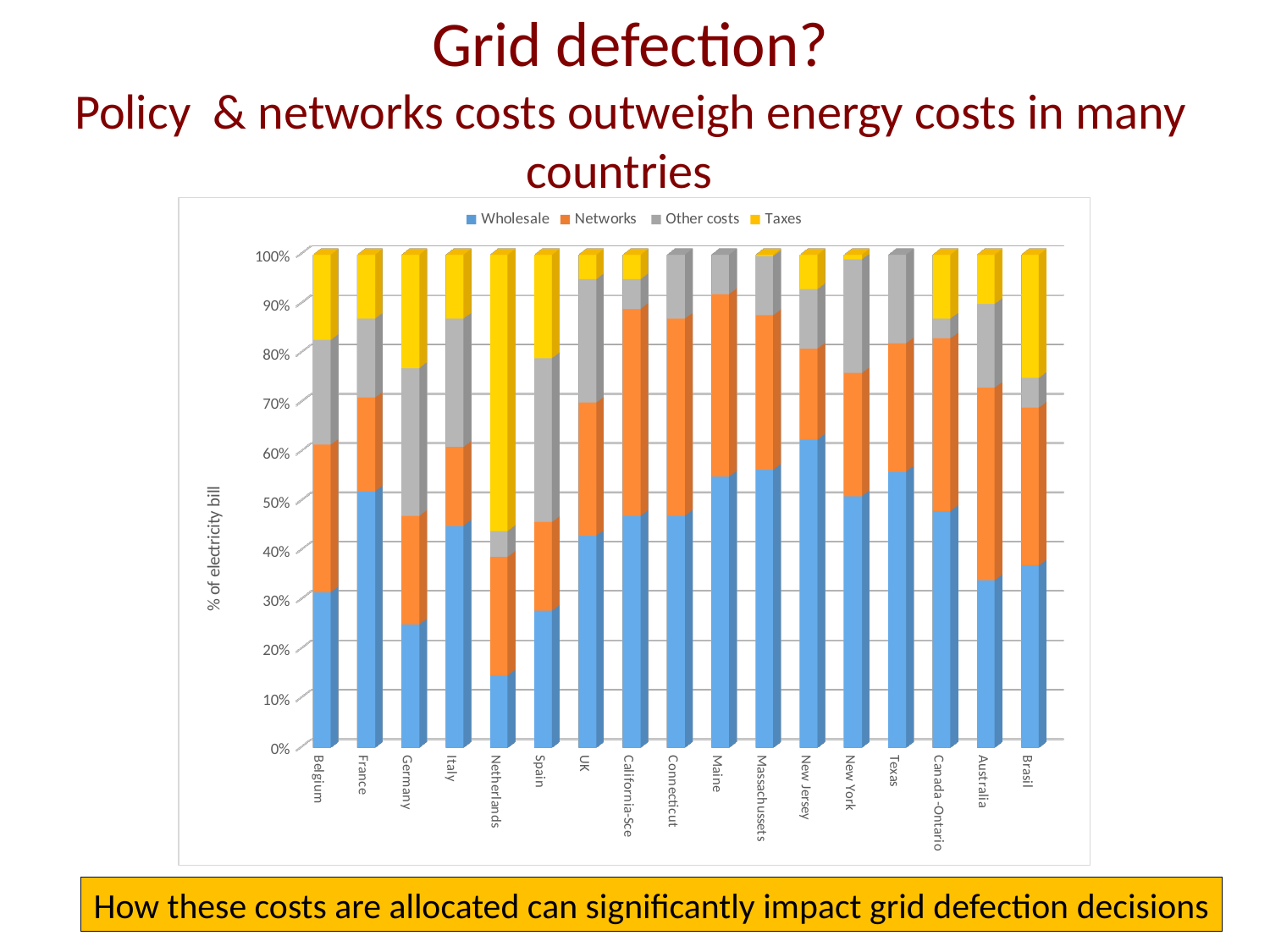
How many countries or regions are shown on the x axis? 17 Is the Wholesale share for New Jersey greater or less than 60%? greater Is the Wholesale share for Netherlands greater or less than 20%? less Is the Wholesale share for Germany greater or less than 30%? less Which country or region has the smallest Wholesale share of the electricity bill? Netherlands What kind of chart is shown on the slide? Stacked bar chart Which country or region has the largest Wholesale share of the electricity bill? New Jersey Which country or region has the largest Taxes share of the electricity bill? Netherlands Which has the larger Wholesale share, Belgium or France? France Which series is shown in yellow in the legend? Taxes What is the label on the vertical axis? % of electricity bill How many series does the legend list? 4